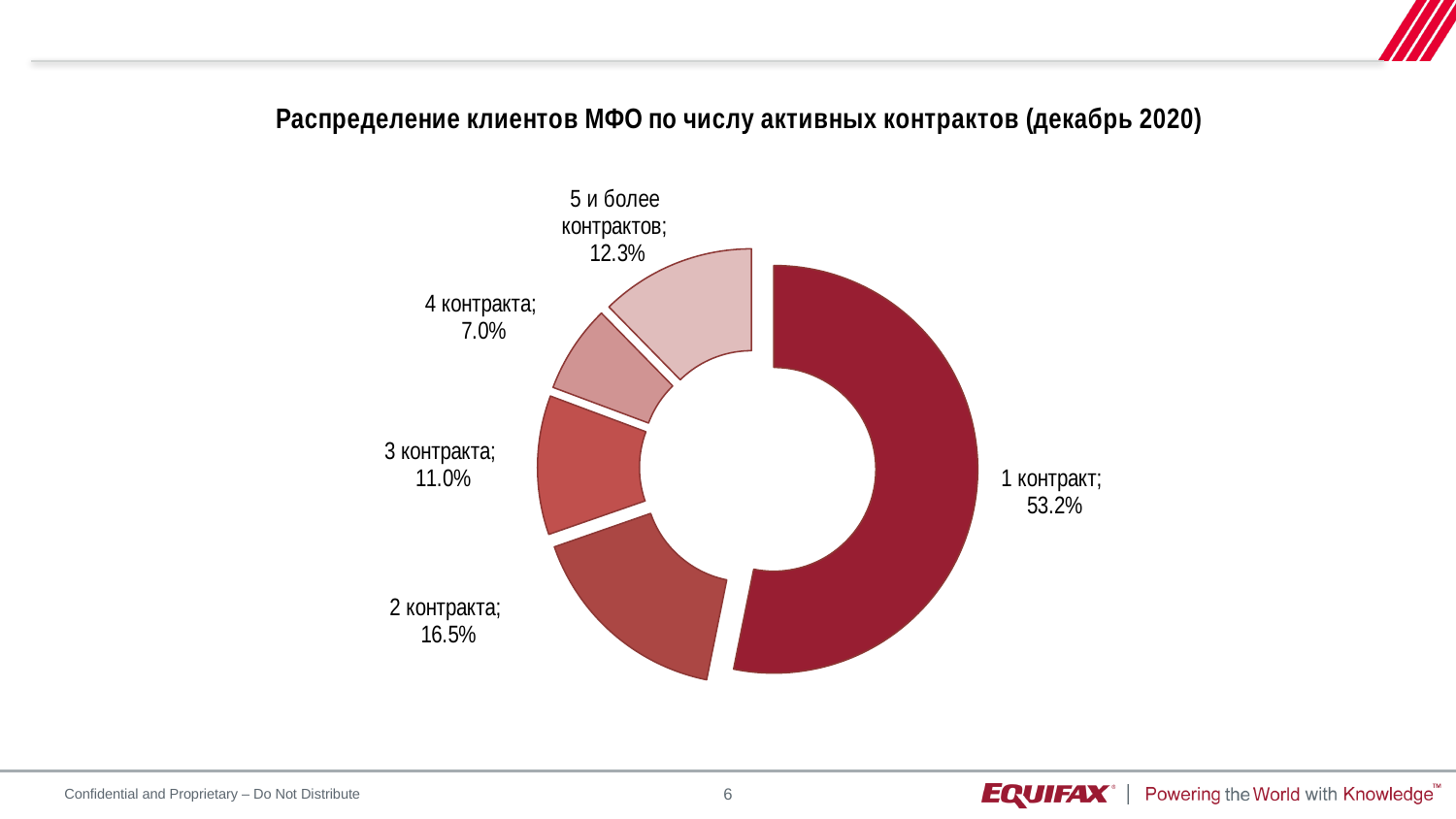
What share of clients have 1 контракт? 53.2% What share of clients have 2 контракта? 16.5% What share of clients have 4 контракта? 7.0% What share of clients have 5 и более контрактов? 12.3% Which category has the smallest share of clients? 4 контракта What is the title of the chart? Распределение клиентов МФО по числу активных контрактов (декабрь 2020) What kind of chart is shown on the slide? Pie chart (doughnut) What is the difference in share between 1 контракт and 2 контракта? 36.7% How many categories are shown in the chart? 5 What share of clients have 3 контракта? 11.0% Which has a larger share: 3 контракта or 5 и более контрактов? 5 и более контрактов Which category has the largest share of clients? 1 контракт